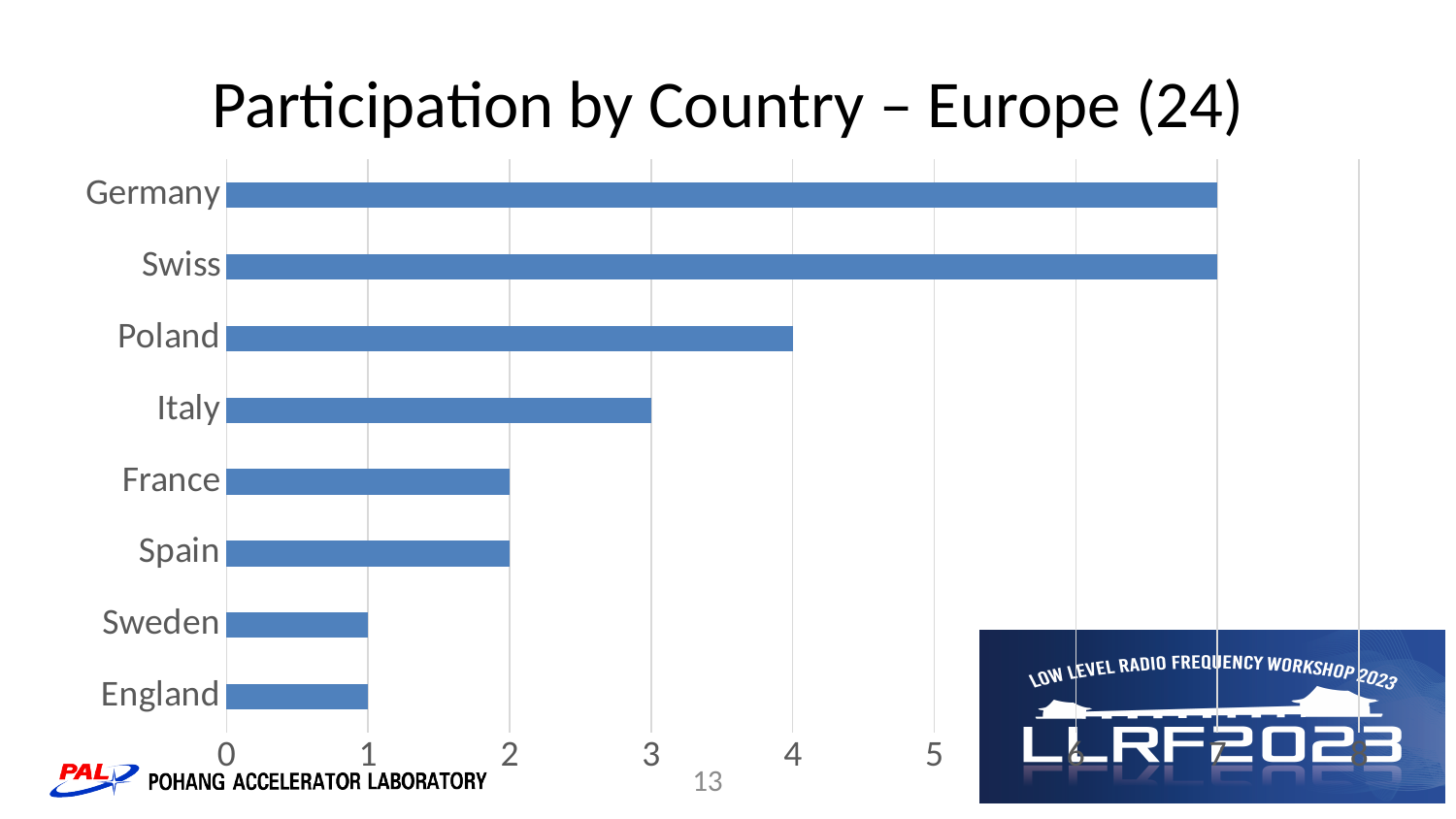
What is the value for France? 2 Is the value for Swiss greater or less than 5? greater What is the difference between the values for Germany and Poland? 3 What is the value for Poland? 4 Which is larger, the value for Spain or the value for England? Spain Which is larger, the value for Poland or the value for Italy? Poland What is the value for Germany? 7 How many countries are shown in the chart? 8 What is the difference between the values for Italy and France? 1 What is the value for Sweden? 1 What kind of chart is shown on the slide? bar chart What is the value for Italy? 3